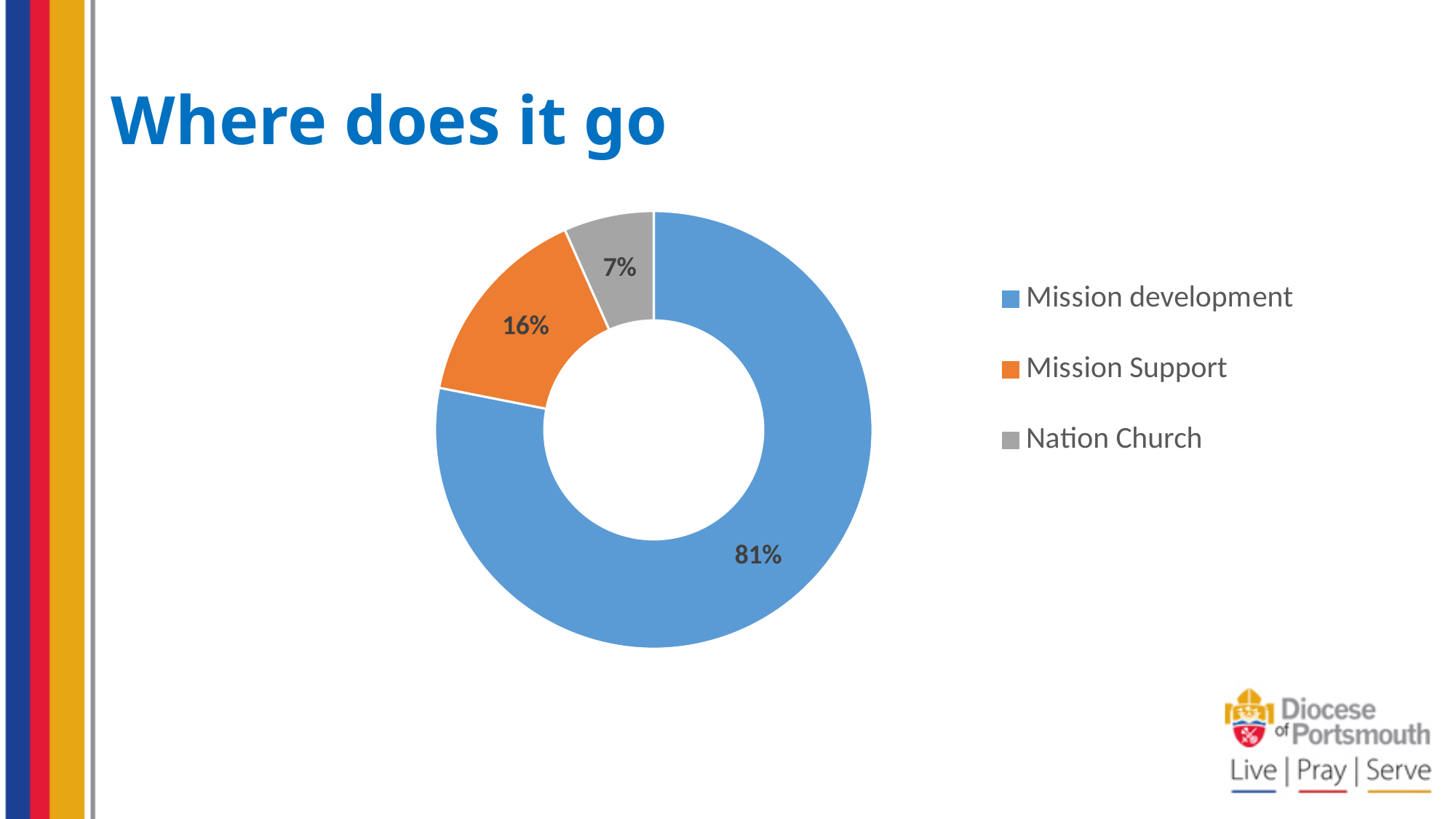
What kind of chart is shown on the slide? Doughnut (pie) chart What share of the chart does Mission development account for? 81% What share of the chart does Mission Support account for? 16% What is the difference in percentage points between Mission development and Mission Support? 65 What share of the chart does Nation Church account for? 7% What is the title of the slide containing the chart? Where does it go What is the difference in percentage points between Mission Support and Nation Church? 9 Which colour represents Mission Support in the chart? Orange Which category has the largest share of the chart? Mission development Which is larger, the share for Mission Support or the share for Nation Church? Mission Support Which category has the smallest share of the chart? Nation Church How many categories are shown in the chart? 3